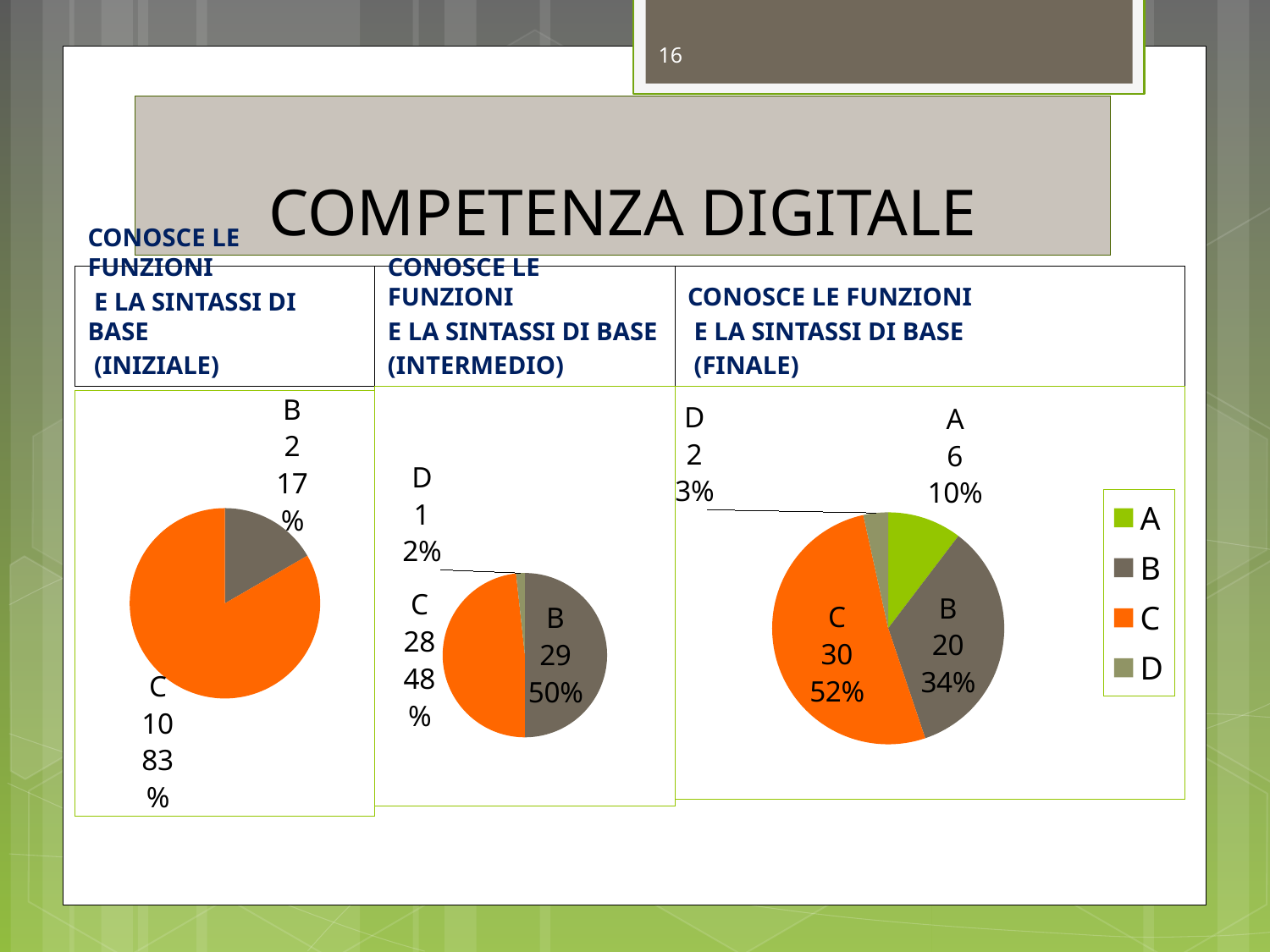
In the FINALE pie chart, what is the difference between the values for C and B? 10 In the INIZIALE pie chart, what percentage is shown for category B? 17% In the INTERMEDIO pie chart, which category has the smallest slice? D In the INTERMEDIO pie chart, what percentage is shown for category C? 48% In the FINALE pie chart, which category has the largest slice? C How many categories are shown in the FINALE pie chart? 4 In the INTERMEDIO pie chart, what value is shown for category B? 29 In the FINALE pie chart, what percentage is shown for category A? 10% In the FINALE pie chart, which is larger, the value for B or the value for A? B What type of chart is used for the INIZIALE data? Pie chart In the INIZIALE pie chart, what value is shown for category C? 10 In the FINALE pie chart, what value is shown for category C? 30